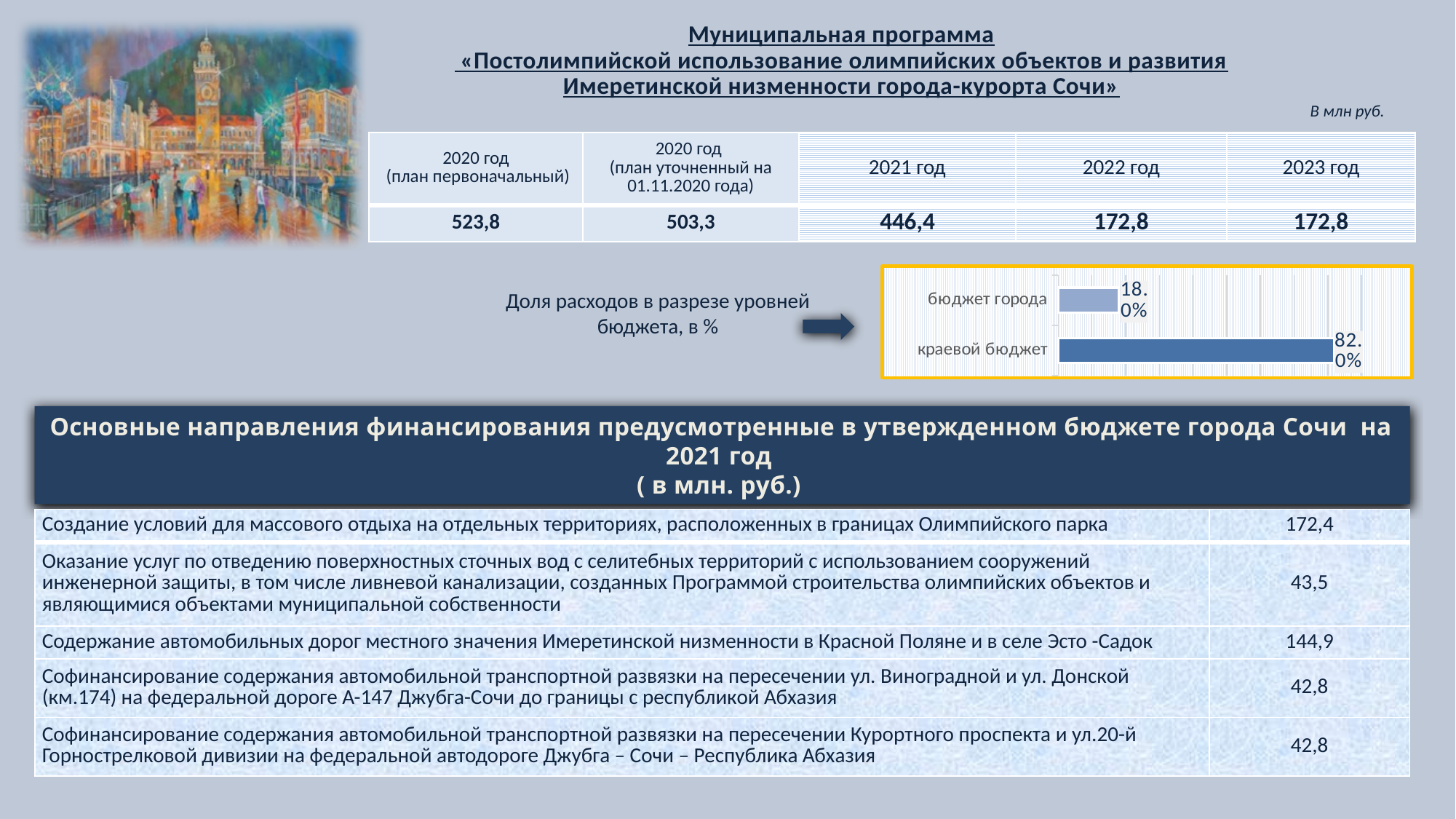
What is the total of the two values shown in the chart? 100.0% Which category has the highest value in the chart? краевой бюджет How many categories are shown in the chart? 2 What is the caption text to the left of the chart? Доля расходов в разрезе уровней бюджета, в % What is the value for краевой бюджет in the chart? 82.0% What is the difference between the values for краевой бюджет and бюджет города? 64.0% Which is larger: the value for бюджет города or the value for краевой бюджет? краевой бюджет What kind of chart is shown on the slide? bar chart What is the value for бюджет города in the chart? 18.0% Which category has the lowest value in the chart? бюджет города Are the bars in the chart horizontal or vertical? horizontal